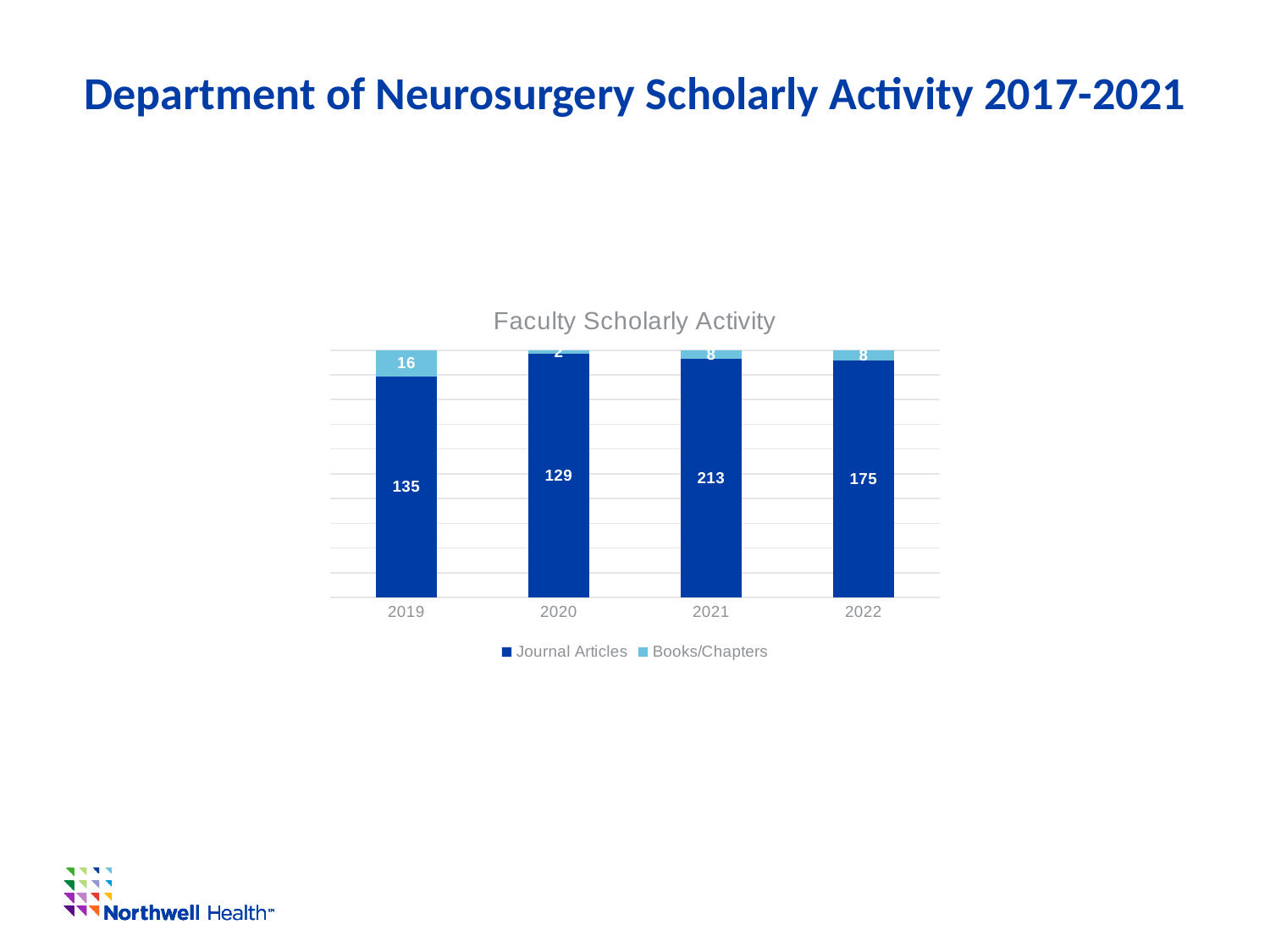
How many series does the legend list? 2 How many Books/Chapters are shown for 2019? 16 Which year has the highest number of Journal Articles? 2021 How many years are shown on the x axis? 4 What is the difference in Journal Articles between 2021 and 2022? 38 Which year has the lowest number of Books/Chapters? 2020 What kind of chart is shown? Stacked bar chart Which year has more Journal Articles, 2019 or 2020? 2019 What is the title of the chart? Faculty Scholarly Activity How many Journal Articles are shown for 2021? 213 What is the total of Journal Articles and Books/Chapters for 2022? 183 What is the Journal Articles value for 2020? 129